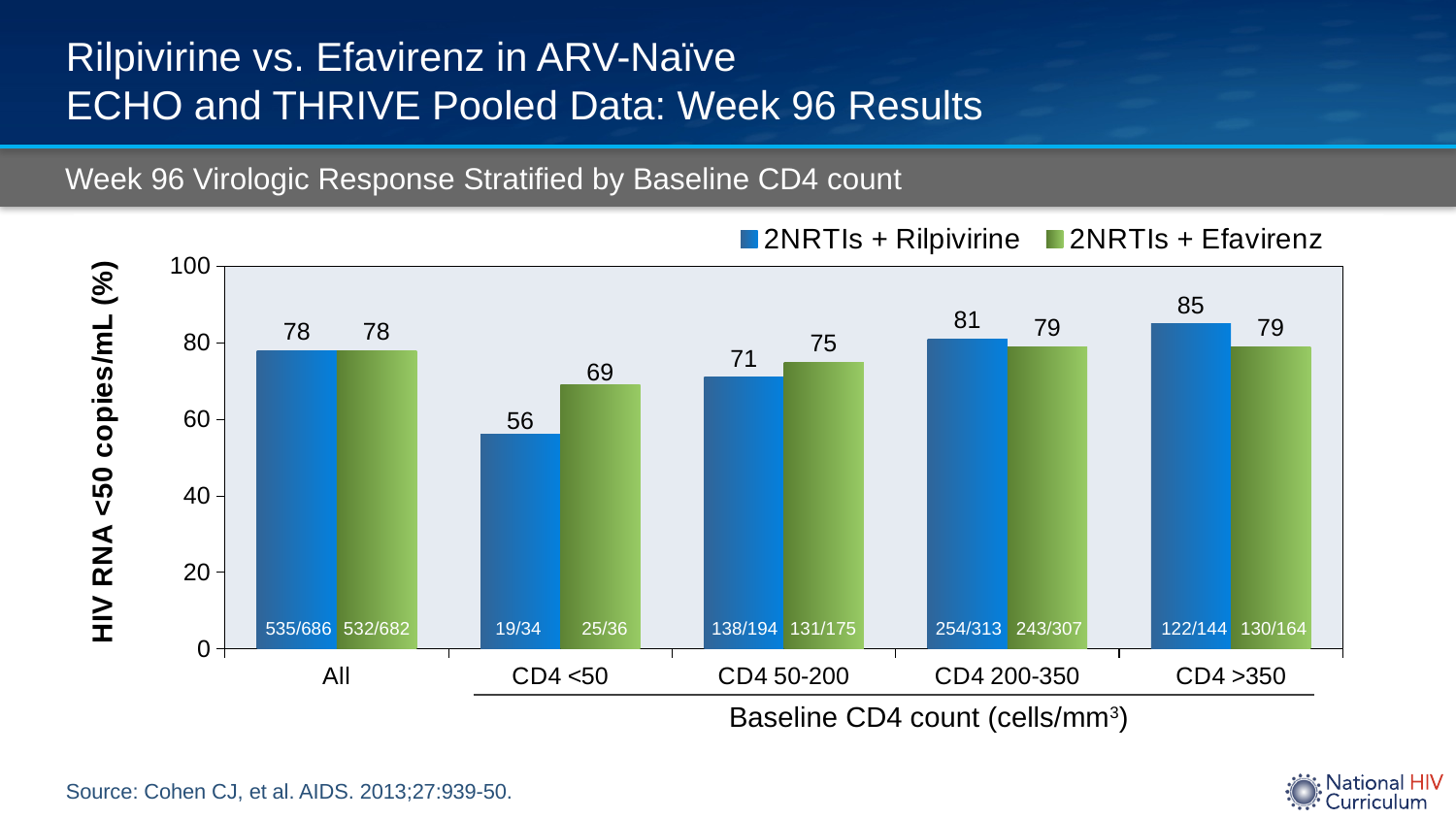
How many series does the legend list? 2 Is the value for 2NRTIs + Rilpivirine in the CD4 50-200 category greater or less than 80? less How many baseline CD4 categories are shown on the x axis? 5 Which category has the lowest value for 2NRTIs + Efavirenz? CD4 <50 Which category has the highest value for 2NRTIs + Rilpivirine? CD4 >350 What is the label of the y axis? HIV RNA <50 copies/mL (%) In the CD4 200-350 category, which series has the larger value? 2NRTIs + Rilpivirine What is the value for 2NRTIs + Efavirenz in the CD4 50-200 category? 75 What kind of chart is shown on the slide? Bar chart What is the value for 2NRTIs + Rilpivirine in the CD4 >350 category? 85 What is the value for 2NRTIs + Rilpivirine in the CD4 <50 category? 56 What is the difference between the 2NRTIs + Efavirenz and 2NRTIs + Rilpivirine values in the CD4 <50 category? 13